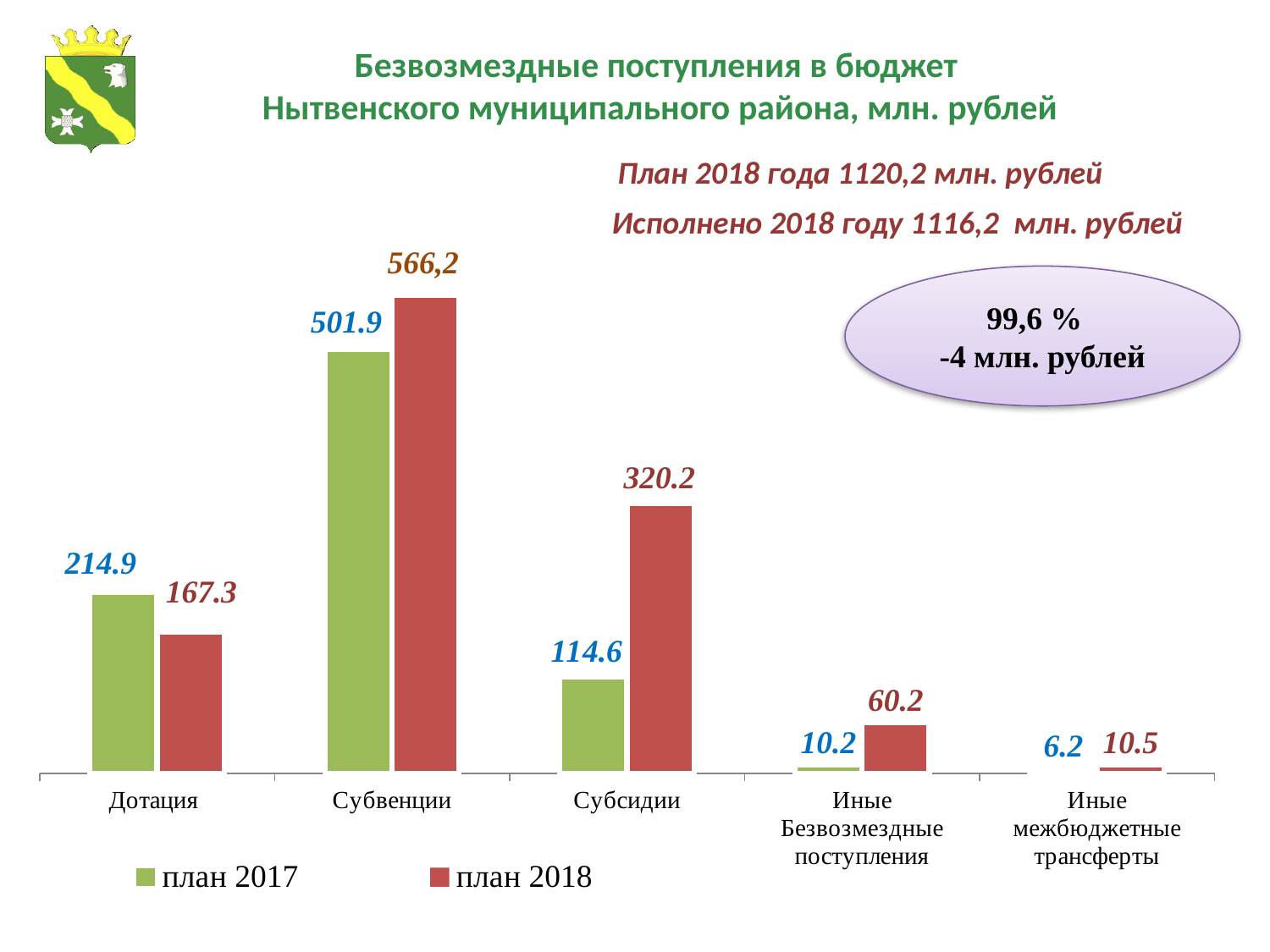
What is the план 2017 value for Иные межбюджетные трансферты? 6.2 What is the план 2018 value for Субсидии? 320.2 Which category has the lowest план 2017 value? Иные межбюджетные трансферты How many categories are shown on the x axis? 5 How many series does the legend list? 2 Which category has the highest план 2018 value? Субвенции What is the difference between the план 2017 and план 2018 values for Дотация? 47.6 What is the план 2018 value for Дотация? 167.3 What is the difference between the план 2018 and план 2017 values for Субсидии? 205.6 What is the план 2017 value for Субвенции? 501.9 For Иные Безвозмездные поступления, which is larger: план 2017 or план 2018? план 2018 What kind of chart is shown on the slide? bar chart